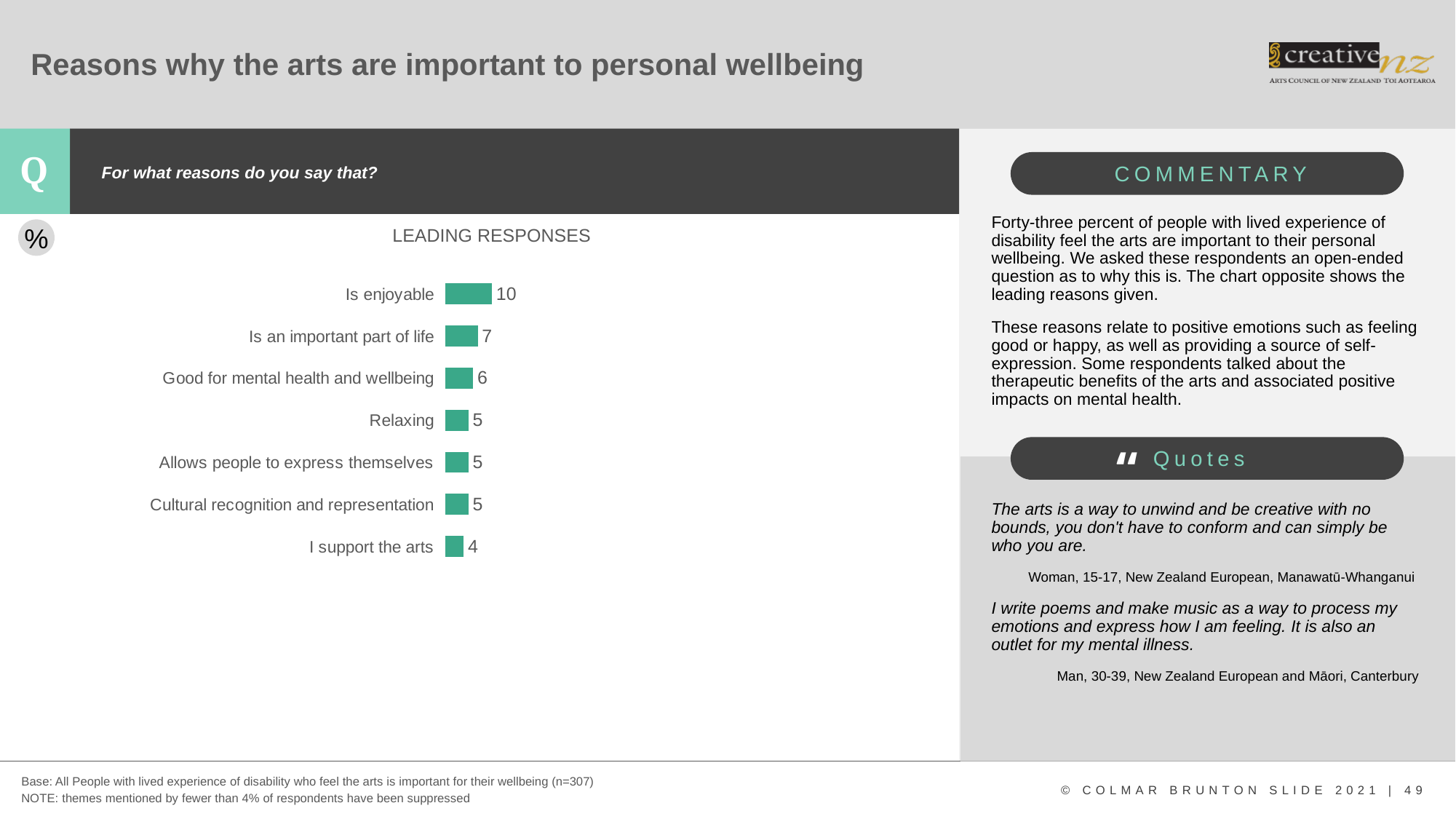
Which category has the lowest value? I support the arts Which category has the highest value? Is enjoyable How many categories are shown in the chart? 7 What is the value for "Is enjoyable"? 10 What is the value for "Good for mental health and wellbeing"? 6 What is the value for "Is an important part of life"? 7 What is the value for "I support the arts"? 4 Which is larger, the value for "Is an important part of life" or the value for "Cultural recognition and representation"? Is an important part of life What is the title of the chart? LEADING RESPONSES What kind of chart is shown on the slide? Bar chart What is the difference between the values for "Is enjoyable" and "Relaxing"? 5 How many categories have a value of 5? 3